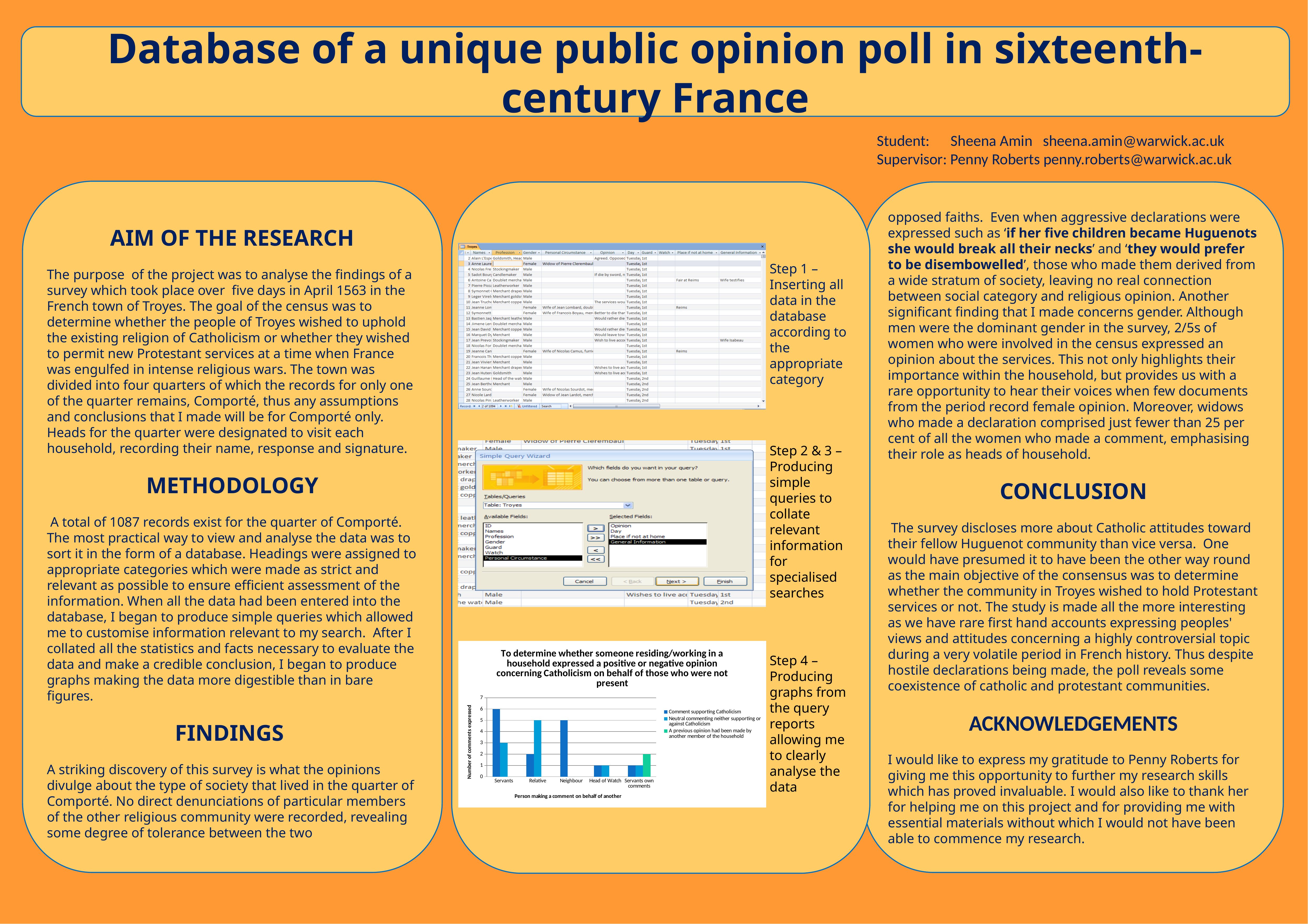
Is the value for 'Comment supporting Catholicism' for Relative greater or less than 3? less How many categories are shown on the x axis of the bar chart? 5 Is the value for 'Neutral commenting neither supporting or against Catholicism' for Relative greater or less than 4? greater Which category has the highest value for 'Comment supporting Catholicism'? Servants What is the title of the x axis of the bar chart? Person making a comment on behalf of another How many series does the legend of the bar chart list? 3 What kind of chart is shown on the slide? bar chart Which category is the only one with a bar for 'A previous opinion had been made by another member of the household'? Servants own comments Is the value for 'Comment supporting Catholicism' for Servants greater or less than 5? greater For Relative, which is larger: 'Comment supporting Catholicism' or 'Neutral commenting neither supporting or against Catholicism'? Neutral commenting neither supporting or against Catholicism What is the title of the y axis of the bar chart? Number of comments expressed Which category has the highest value for 'Neutral commenting neither supporting or against Catholicism'? Relative